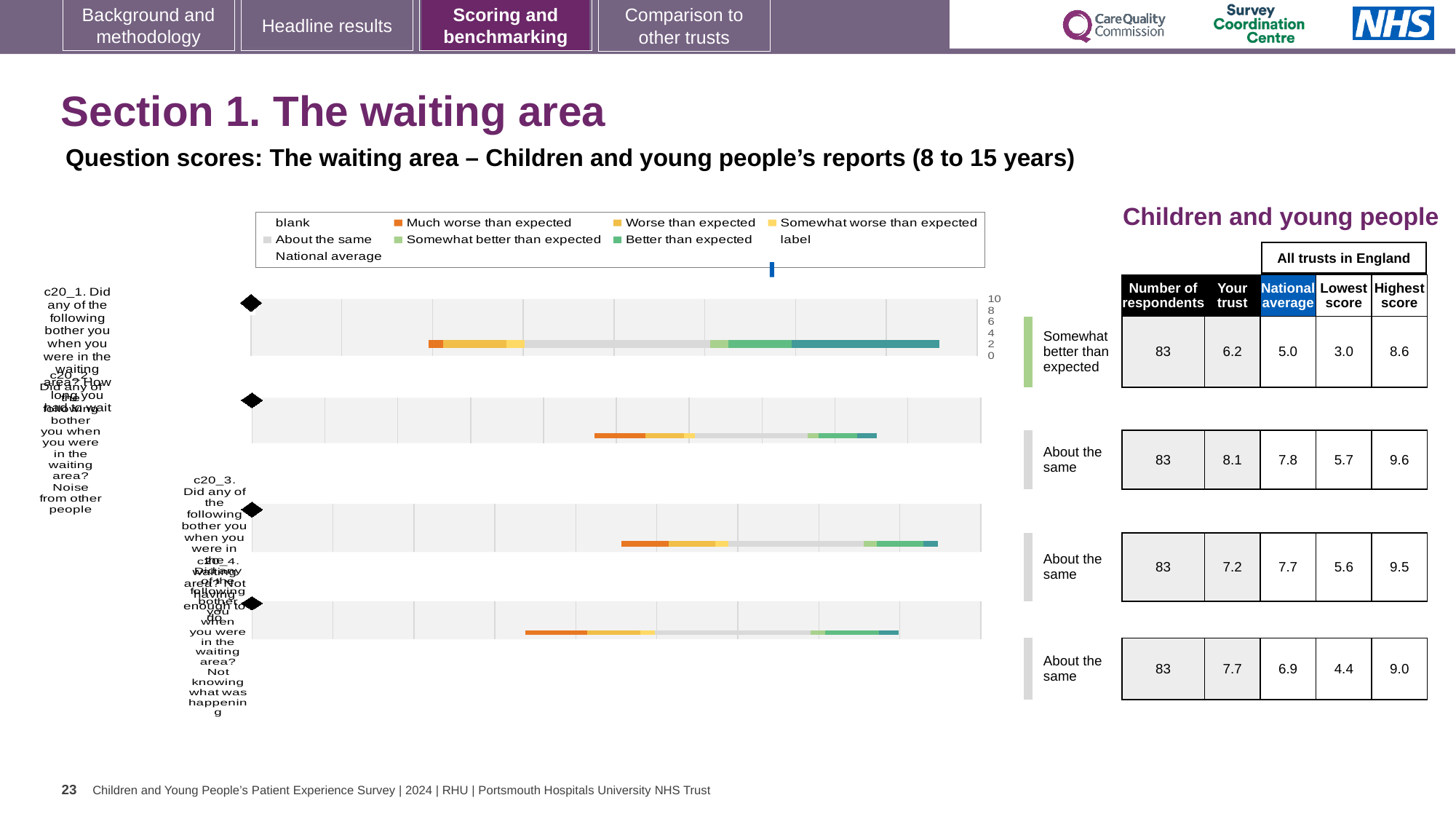
What kind of chart is shown on the slide? bar chart How many question rows (bars) does the chart show? 4 How many entries does the chart legend list? 9 What is the difference between the 'Your trust' scores for c20_2 and c20_1 in the table beside the chart? 1.9 For question c20_3, which is larger in the table beside the chart: the 'Your trust' score or the national average? National average Which question row has the lowest 'Your trust' score in the table beside the chart? c20_1 In the table beside the chart, what is the highest score for question c20_3? 9.5 In the table beside the chart, what is the lowest score for question c20_4? 4.4 In the table beside the chart, what is the 'Your trust' score for question c20_1? 6.2 Which question row has the highest 'Your trust' score in the table beside the chart? c20_2 In the table beside the chart, what is the national average for question c20_2? 7.8 In the legend, what colour represents 'Much worse than expected'? orange